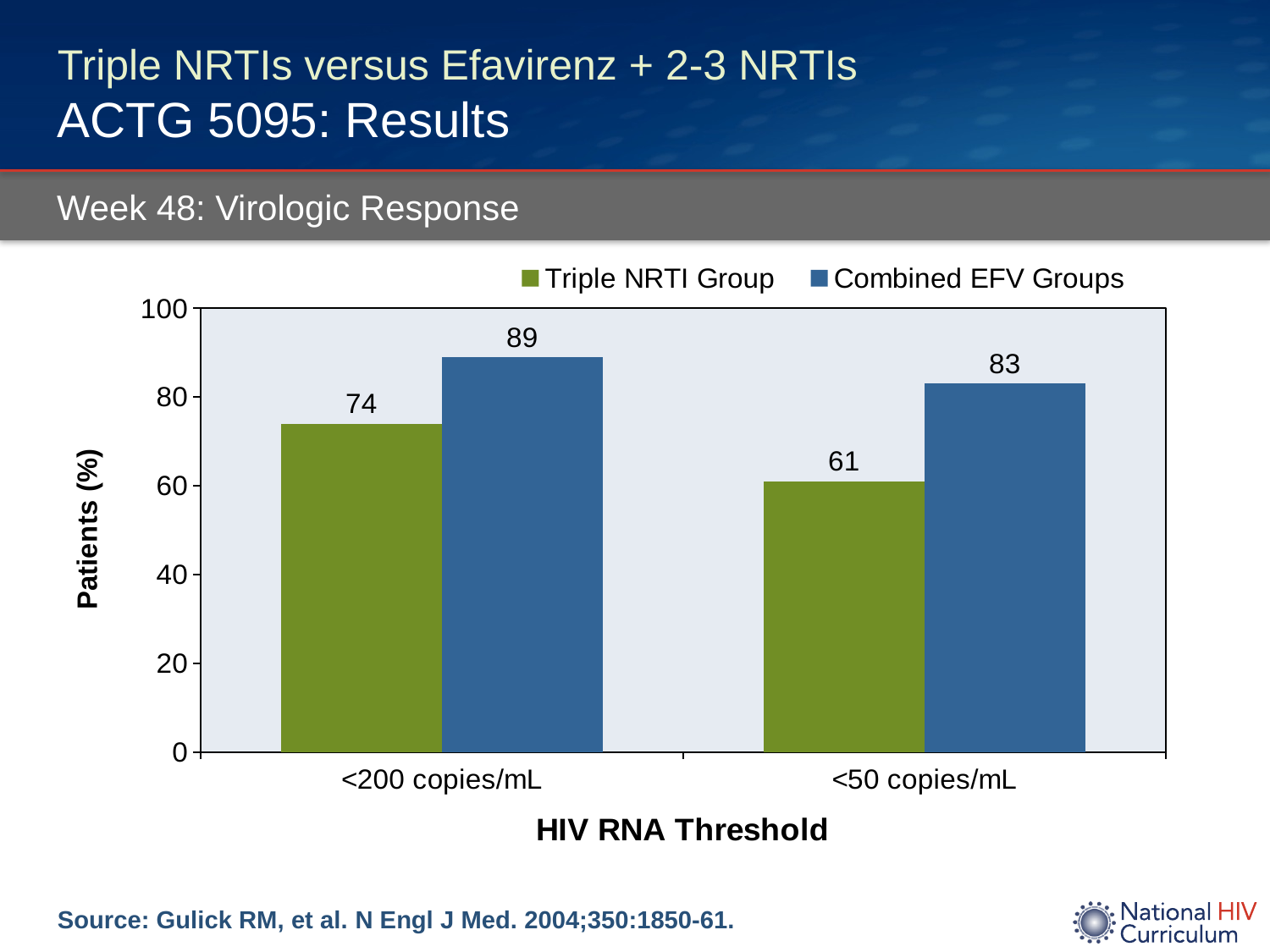
What is the value for the Combined EFV Groups at the <50 copies/mL threshold? 83 Which bar has the lowest value on the chart? Triple NRTI Group at <50 copies/mL What is the value for the Triple NRTI Group at the <200 copies/mL threshold? 74 Which is larger at the <200 copies/mL threshold: the Triple NRTI Group or the Combined EFV Groups? Combined EFV Groups What is the label of the y axis? Patients (%) How many HIV RNA threshold categories are shown on the x axis? 2 What is the value for the Combined EFV Groups at the <200 copies/mL threshold? 89 Which bar has the highest value on the chart? Combined EFV Groups at <200 copies/mL What is the difference between the Combined EFV Groups and the Triple NRTI Group at the <50 copies/mL threshold? 22 What is the value for the Triple NRTI Group at the <50 copies/mL threshold? 61 What kind of chart is shown on the slide? Bar chart How many series does the legend list? 2